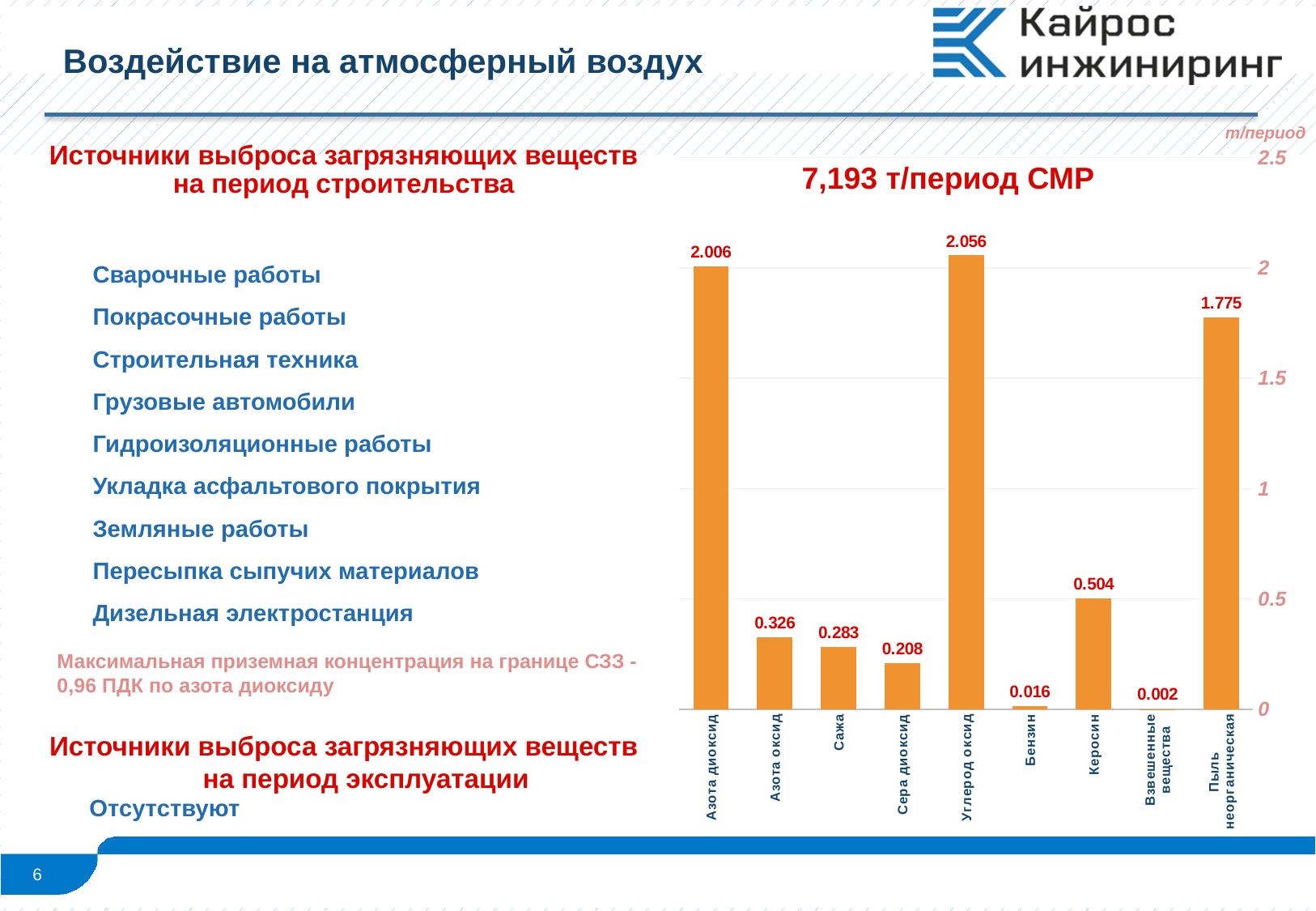
What unit is shown above the vertical axis of the chart? т/период What is the difference between the values for Углерод оксид and Азота диоксид? 0.050 Which category has the highest value? Углерод оксид What is the value for Углерод оксид? 2.056 Is the value for Пыль неорганическая greater or less than 1.5? greater Which category has the lowest value? Взвешенные вещества What is the title of the chart? 7,193 т/период СМР How many categories are shown on the x axis of the chart? 9 Which is larger, the value for Азота оксид or the value for Сажа? Азота оксид What is the value for Керосин? 0.504 What is the value for Пыль неорганическая? 1.775 What kind of chart is shown on the slide? bar chart